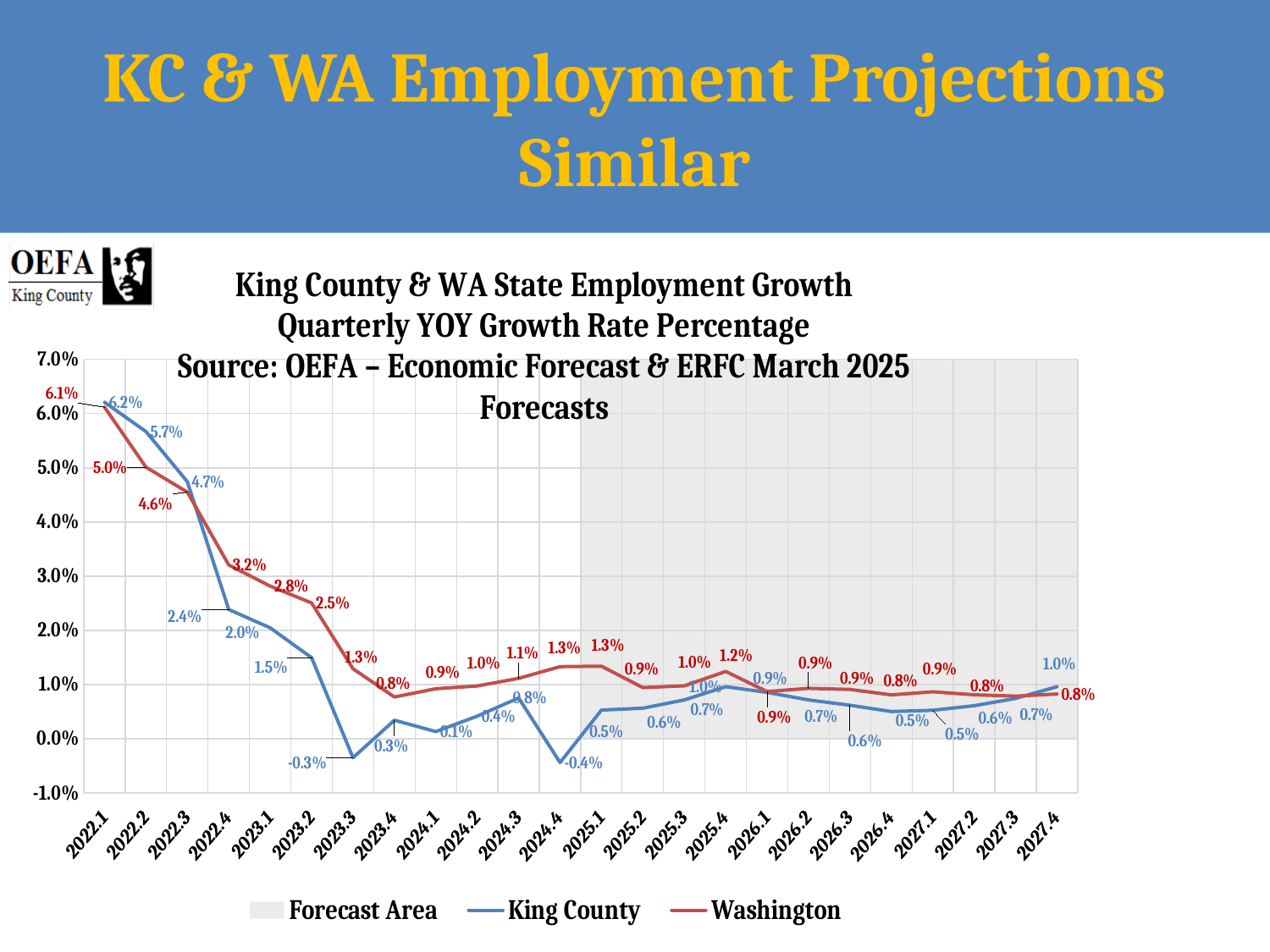
What kind of chart is shown on the slide? line chart What does the grey shaded region of the chart represent? Forecast Area What is the difference between the King County and Washington growth rates in 2022.4? 0.8 percentage points What is the King County growth rate for 2022.1? 6.2% In 2022.2, which is larger: the King County or the Washington growth rate? King County In which quarter is the King County growth rate highest? 2022.1 How many entries does the chart legend list? 3 What is the Washington growth rate for 2022.1? 6.1% What is the Washington growth rate for 2022.4? 3.2% In which quarter is the King County growth rate lowest? 2024.4 How many quarters are plotted along the x axis? 24 What is the King County growth rate for 2023.3? -0.3%